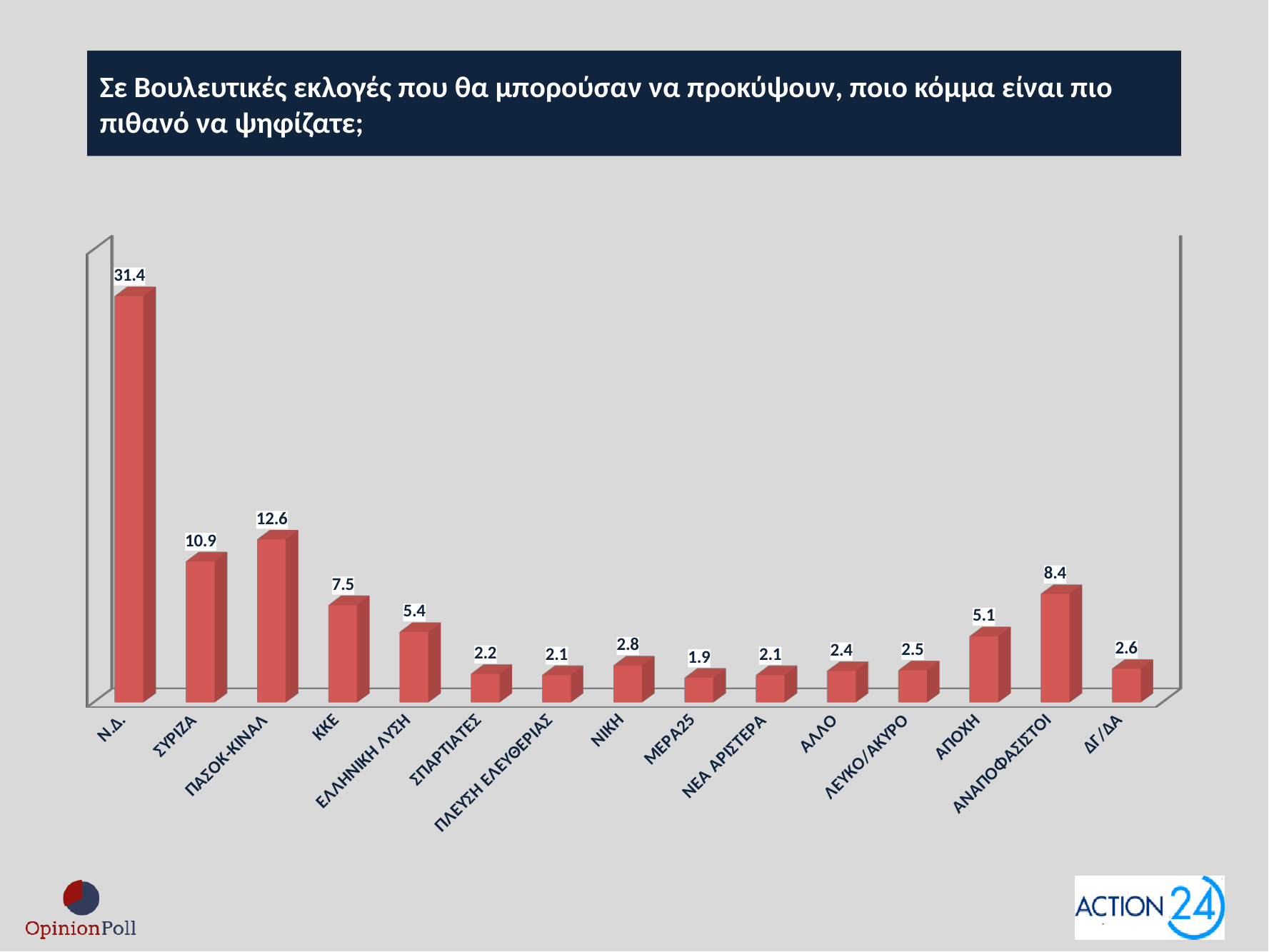
What is the difference between the values for ΠΑΣΟΚ-ΚΙΝΑΛ and ΚΚΕ? 5.1 How many categories are shown on the chart? 15 Which is larger, the value for ΑΠΟΧΗ or the value for ΑΝΑΠΟΦΑΣΙΣΤΟΙ? ΑΝΑΠΟΦΑΣΙΣΤΟΙ What kind of chart is shown on the slide? Bar chart What is the value for ΑΝΑΠΟΦΑΣΙΣΤΟΙ? 8.4 Which category has the lowest value? ΜΕΡΑ25 What is the difference between the values for Ν.Δ. and ΣΥΡΙΖΑ? 20.5 Which category has the highest value? Ν.Δ. What is the value for Ν.Δ.? 31.4 What is the value for ΠΑΣΟΚ-ΚΙΝΑΛ? 12.6 Which is larger, the value for ΣΥΡΙΖΑ or the value for ΠΑΣΟΚ-ΚΙΝΑΛ? ΠΑΣΟΚ-ΚΙΝΑΛ What is the value for ΕΛΛΗΝΙΚΗ ΛΥΣΗ? 5.4